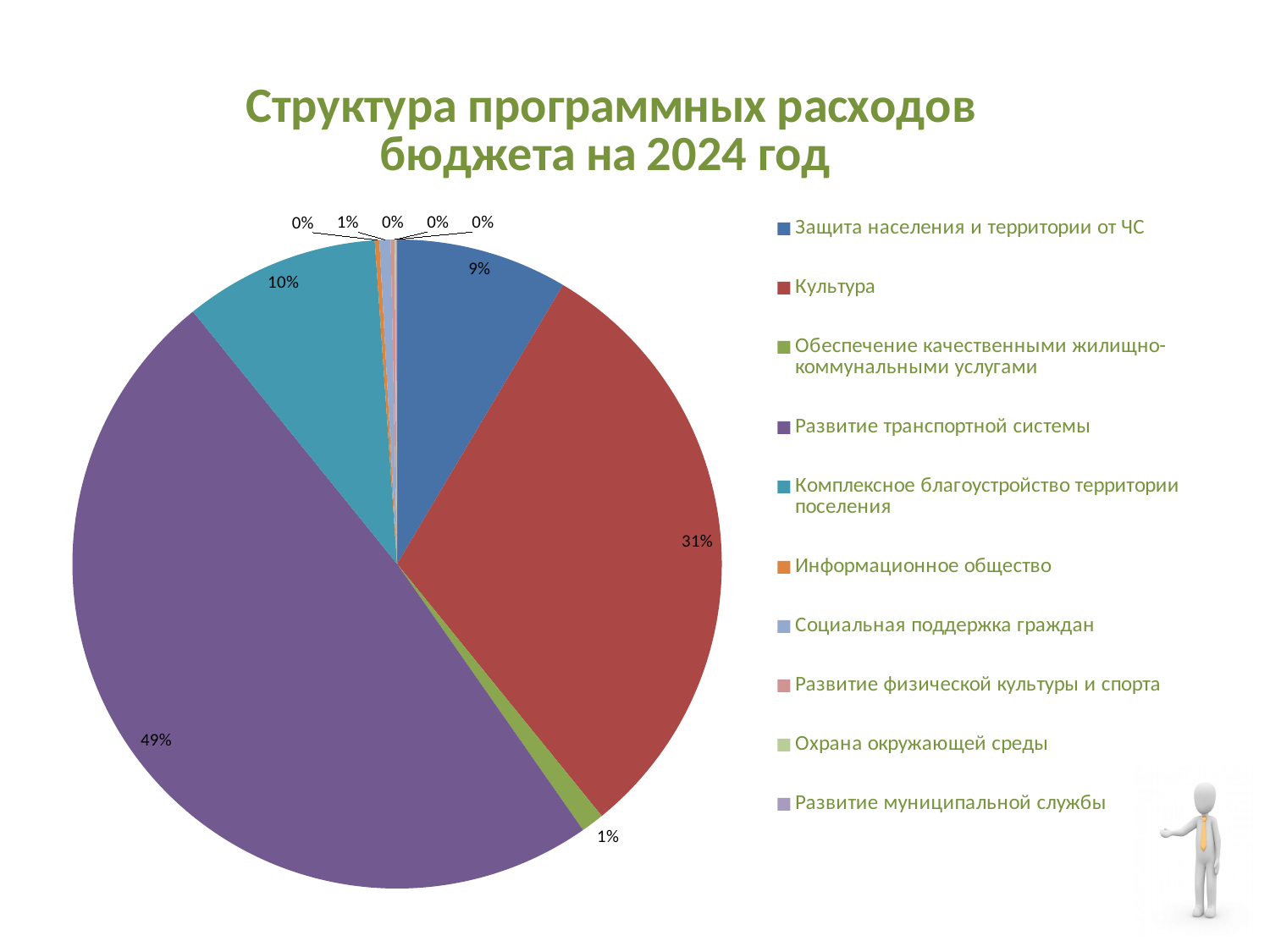
What is the difference in percentage points between "Развитие транспортной системы" and "Культура"? 18 What kind of chart is shown on the slide? Pie chart What is the combined share of "Развитие транспортной системы" and "Культура"? 80% What share of the pie does "Культура" take? 31% What share of the pie does "Обеспечение качественными жилищно-коммунальными услугами" take? 1% What share of the pie does "Комплексное благоустройство территории поселения" take? 10% What is the title of the chart? Структура программных расходов бюджета на 2024 год What share of the pie does "Развитие транспортной системы" take? 49% What share of the pie does "Защита населения и территории от ЧС" take? 9% How many categories does the legend list? 10 Which category has the largest share of the pie? Развитие транспортной системы Which has a larger share: "Культура" or "Комплексное благоустройство территории поселения"? Культура